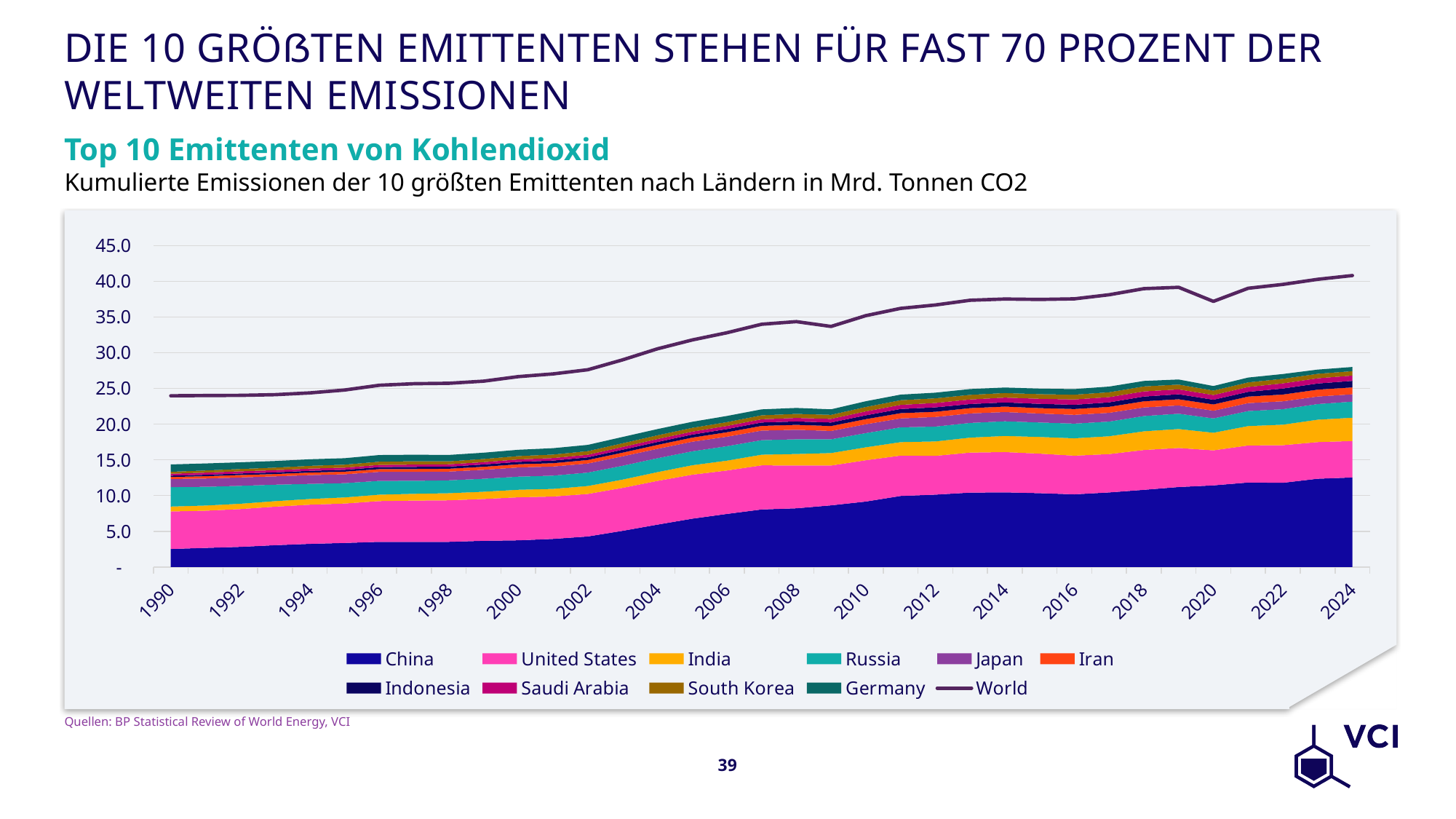
Is the World value in 1990 greater or less than 30.0? less Is the value for China in 2024 greater or less than 10.0? greater Which is higher: the World value in 2019 or in 2020? 2019 Does the World line rise or fall from 1990 to 2024? rises What kind of chart is shown on the slide? stacked area chart with a line How many series does the legend list? 11 Is the value for China in 1990 greater or less than 5.0? less In 2024, which is larger: the emissions of China or of the United States? China Does the China area rise or fall from 1990 to 2024? rises Which series is plotted at the bottom of the stacked areas? China